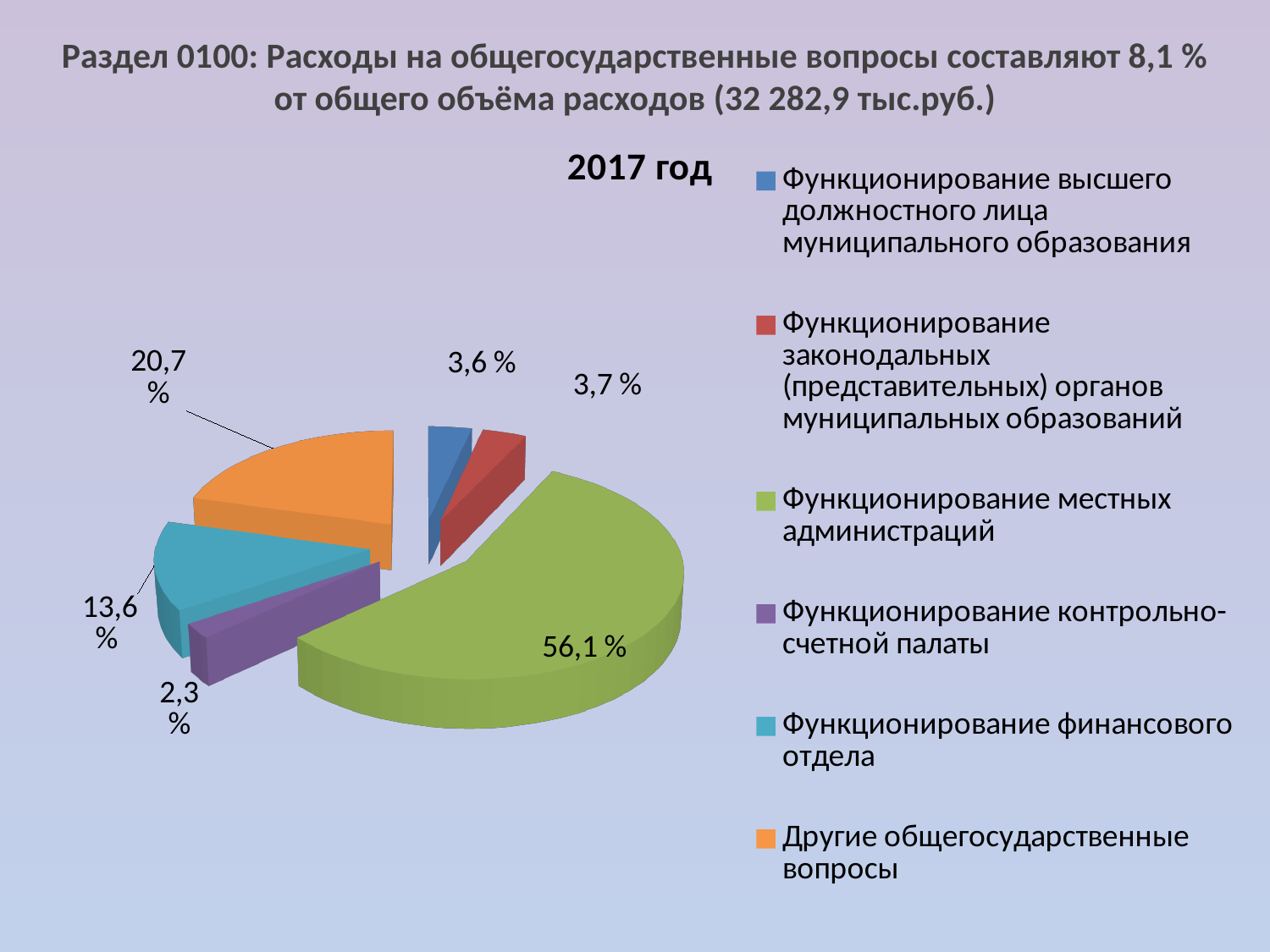
What share of the pie is 'Функционирование местных администраций'? 56,1 % What is the value for 'Другие общегосударственные вопросы'? 20,7 % What is the difference between the shares of 'Другие общегосударственные вопросы' and 'Функционирование финансового отдела'? 7,1 % How many entries does the legend list? 6 Which is larger: the share for 'Функционирование финансового отдела' or for 'Функционирование контрольно-счетной палаты'? Функционирование финансового отдела How many slices does the pie chart have? 6 Which category has the largest share of the pie? Функционирование местных администраций What is the value for 'Функционирование финансового отдела'? 13,6 % What kind of chart is shown on the slide? Pie chart Which category has the smallest share of the pie? Функционирование контрольно-счетной палаты What is the value for 'Функционирование контрольно-счетной палаты'? 2,3 % What is the chart's title? 2017 год